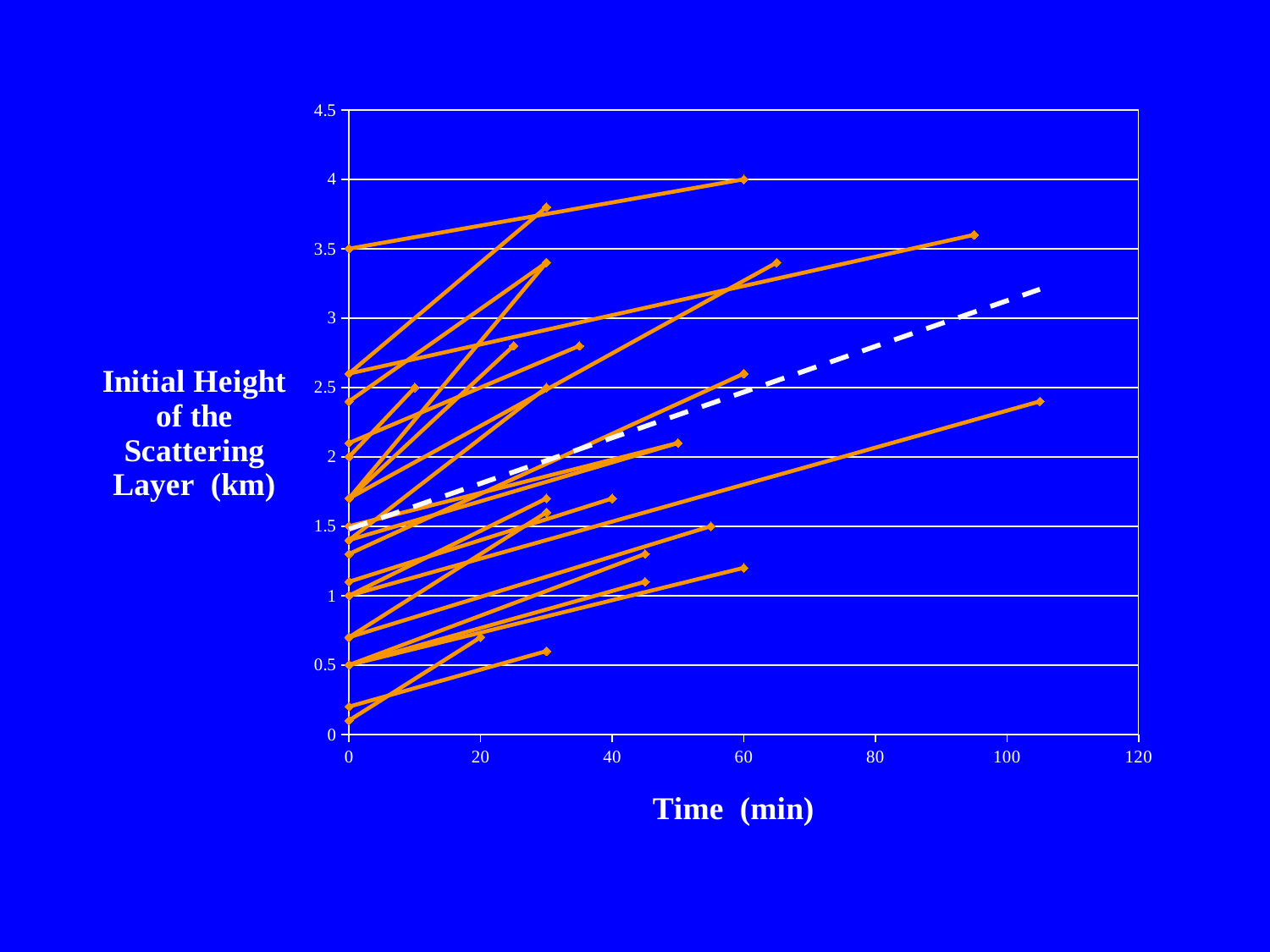
Do the orange lines rise or fall as time increases along the x axis? rise What is the label of the x axis? Time (min) Is the end value of the orange line that reaches 60 min at the top of the chart greater or less than 3.5? greater What kind of chart is shown on the slide? line chart What is the label of the y axis? Initial Height of the Scattering Layer (km) Is the value at the right end of the white dashed line greater or less than 3? greater What is the highest initial height value at time 0 among the orange lines? 3.5 What is the highest height value reached by any orange line on the chart? 4 Does the white dashed line rise or fall from left to right? rise Is the end value of the orange line that extends furthest to the right (past 100 min) greater or less than 2? greater